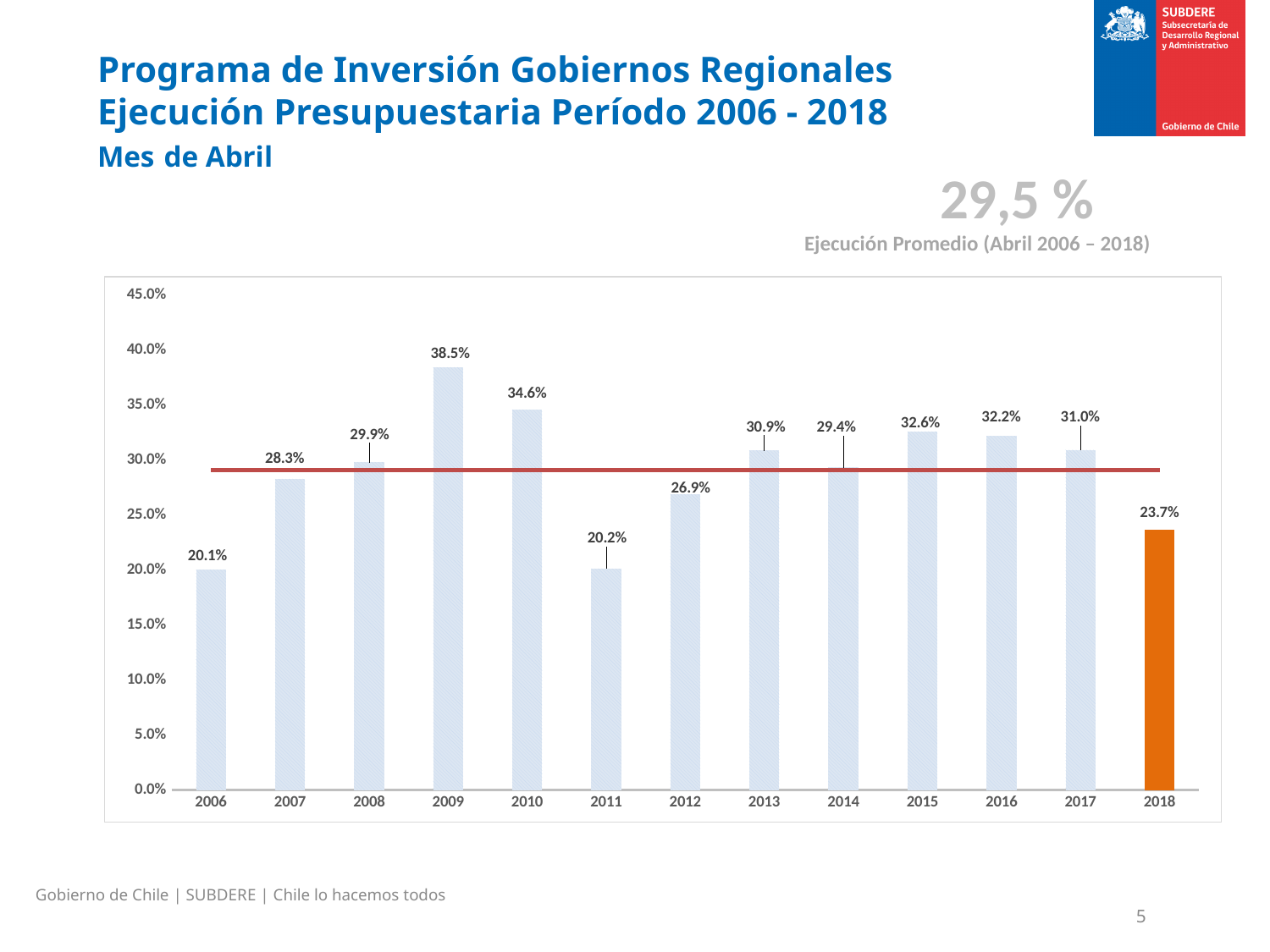
What is the value for 2009? 38.5% What average execution value is shown above the chart for April 2006 – 2018? 29,5 % How many years are shown on the x axis? 13 Which year has the lowest value? 2006 Which year has the highest value? 2009 Do the values rise or fall from 2016 to 2018? fall What is the value for 2018? 23.7% Is the value for 2012 greater or less than 30.0%? less What is the difference between the values for 2009 and 2006? 18.4% What kind of chart is this? bar chart Which is larger, the value for 2015 or the value for 2016? 2015 What is the value for 2011? 20.2%